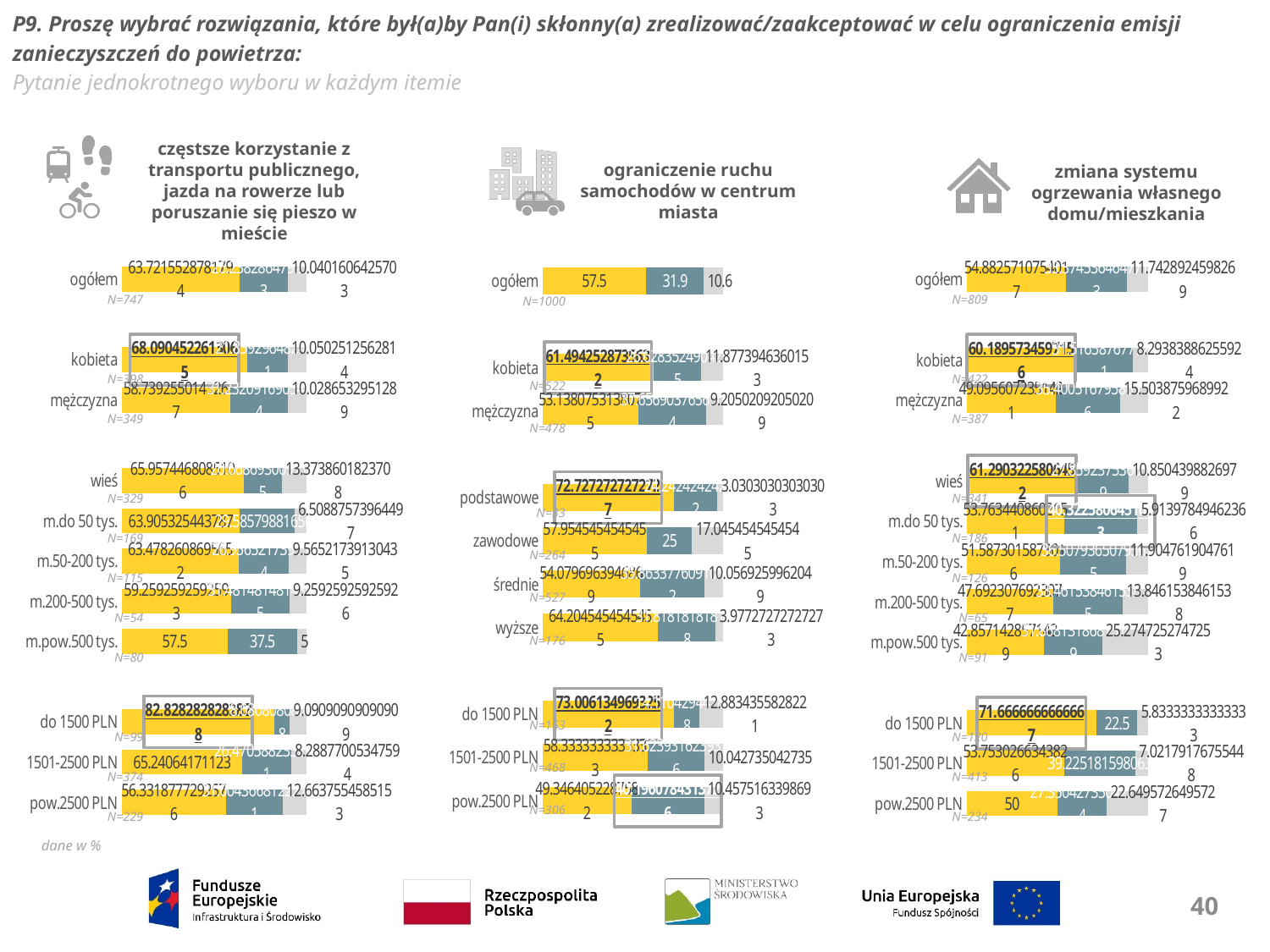
In the right chart (zmiana systemu ogrzewania własnego domu/mieszkania), what is the value of the blue-grey segment for do 1500 PLN? 22.5 What type of chart is used on this slide? bar chart In the left chart (częstsze korzystanie z transportu publicznego), what is the total of the three segments for m.pow.500 tys.? 100 In the middle chart (ograniczenie ruchu samochodów w centrum miasta), what is the value of the light grey segment for ogółem? 10.6 In the middle chart (ograniczenie ruchu samochodów w centrum miasta), what is the difference between the yellow and blue-grey segments for ogółem? 25.6 How many categories (rows) are shown in the middle chart (ograniczenie ruchu samochodów w centrum miasta)? 10 In the right chart (zmiana systemu ogrzewania własnego domu/mieszkania), what is the value of the yellow segment for pow.2500 PLN? 50 In the middle chart (ograniczenie ruchu samochodów w centrum miasta), which segment is larger for ogółem, the yellow or the blue-grey one? yellow In the middle chart (ograniczenie ruchu samochodów w centrum miasta), what is the value of the blue-grey segment for ogółem? 31.9 In the left chart (częstsze korzystanie z transportu publicznego), what is the value of the blue-grey segment for m.pow.500 tys.? 37.5 In the middle chart (ograniczenie ruchu samochodów w centrum miasta), what is the value of the yellow segment for ogółem? 57.5 In the left chart (częstsze korzystanie z transportu publicznego), what is the value of the yellow segment for m.pow.500 tys.? 57.5